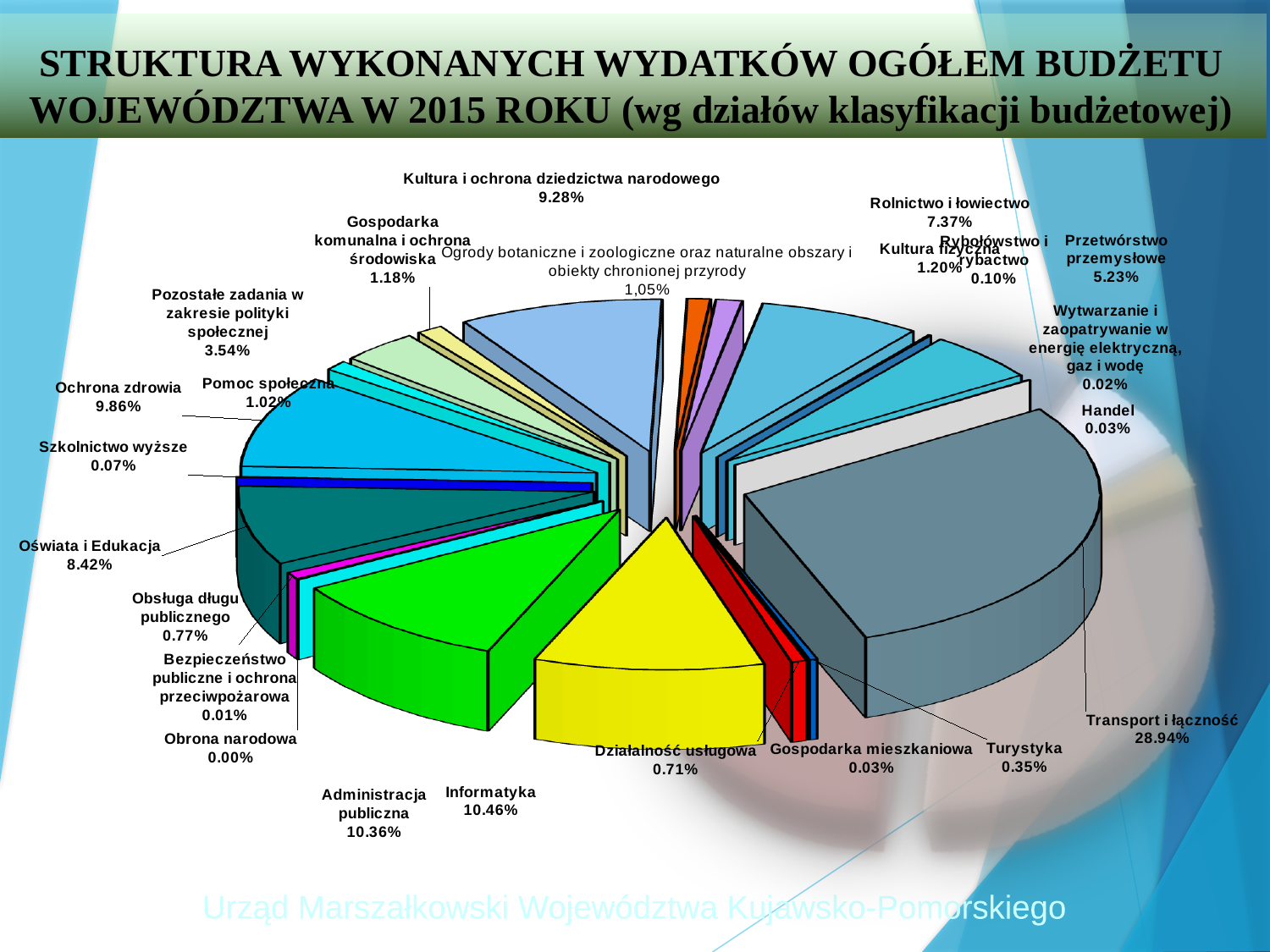
What is the difference in percentage points between Ochrona zdrowia and Kultura i ochrona dziedzictwa narodowego? 0.58 What type of chart is shown on the slide? Pie chart What is the value for Oświata i Edukacja? 8.42% Which category has the largest share of the pie? Transport i łączność What percentage is shown for Ochrona zdrowia? 9.86% Which is larger, Informatyka or Administracja publiczna? Informatyka What is the value shown for Informatyka? 10.46% Which category has the smallest share, shown as 0.00%? Obrona narodowa Which year does the chart title say the expenditure structure refers to? 2015 What share of the budget expenditure does Transport i łączność account for? 28.94% What is the difference in percentage points between Transport i łączność and Informatyka? 18.48 What percentage is shown for Przetwórstwo przemysłowe? 5.23%